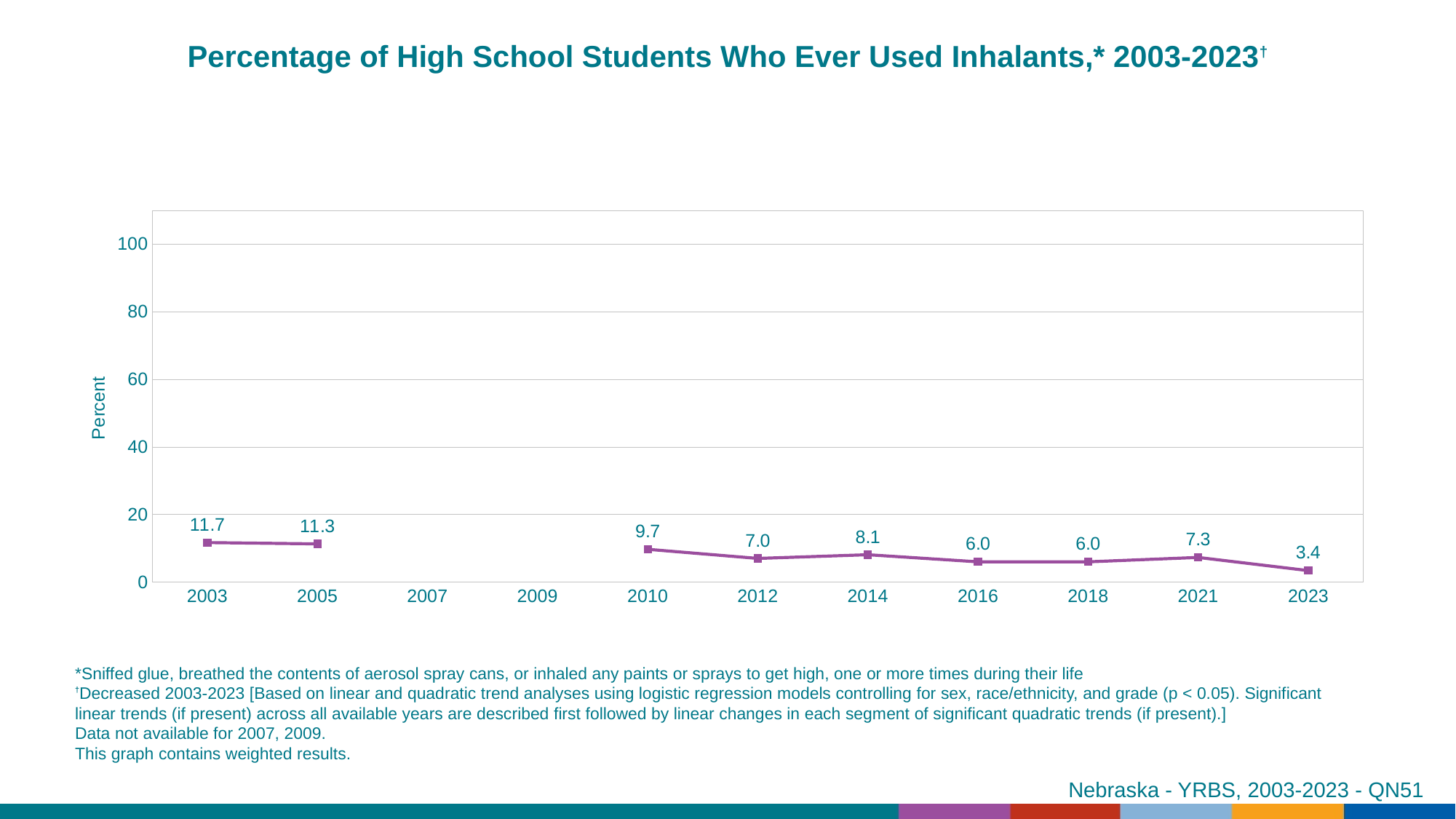
Which is larger, the value for 2012 or the value for 2014? 2014 What is the value plotted for 2023? 3.4 Is the value for 2010 greater or less than 20? less How many data points are plotted on the chart? 9 Which years are noted as having no data available? 2007, 2009 What kind of chart is shown on the slide? line chart What is the difference between the 2003 value and the 2023 value? 8.3 Which year has the highest percentage of students who ever used inhalants? 2003 What is the value plotted for 2014? 8.1 What percentage of high school students had ever used inhalants in 2003? 11.7 Which year has the lowest percentage of students who ever used inhalants? 2023 Overall, do the values rise or fall from 2003 to 2023? fall